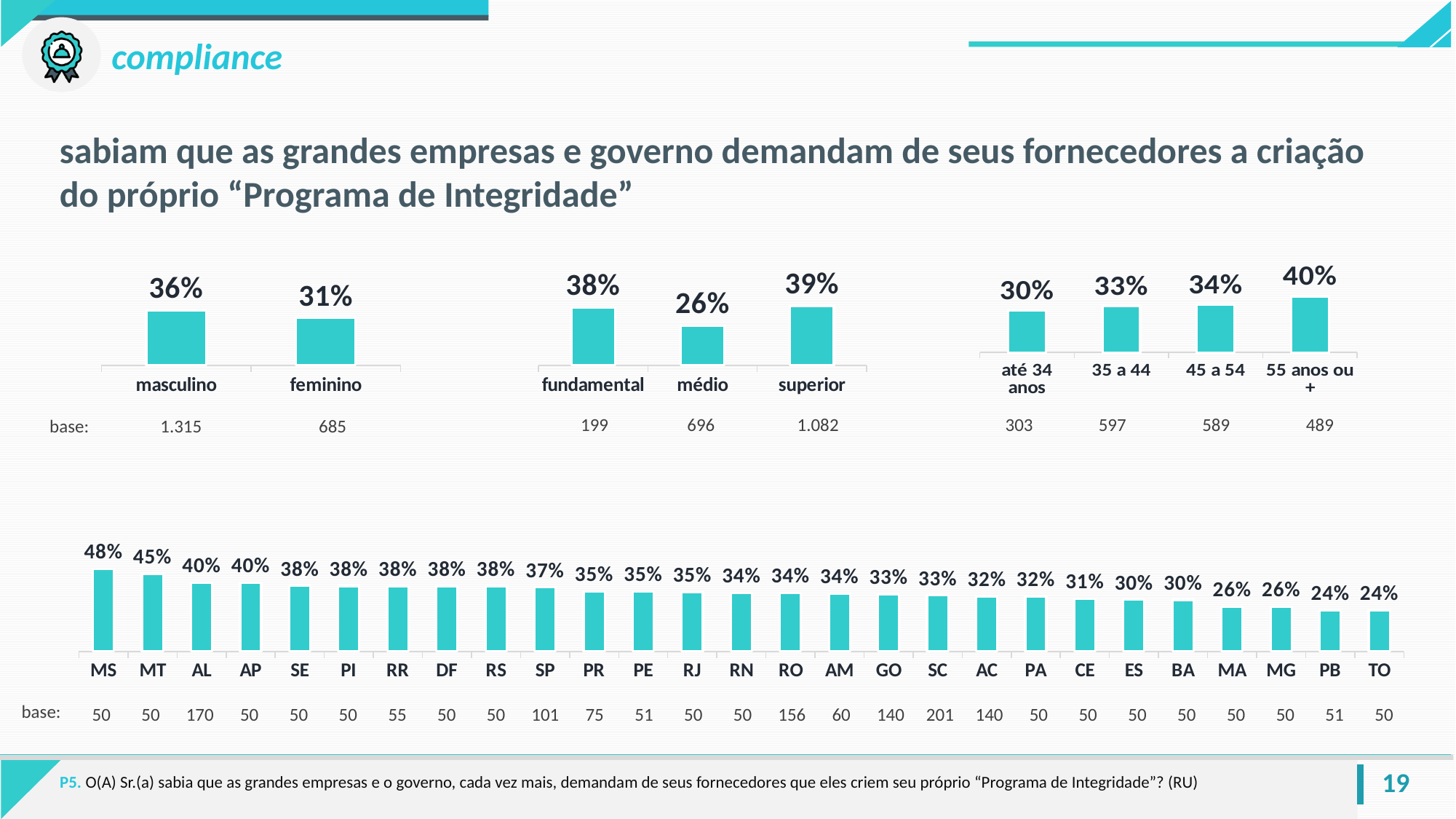
In the state chart (bottom), which state has the highest value? MS What kind of chart is the state chart at the bottom of the slide? bar chart In the age chart (top right), do the values rise or fall from the youngest to the oldest age group? rise In the age chart (top right), what is the value for 35 a 44? 33% In the state chart (bottom), how many states are shown? 27 In the gender chart (top left), what is the value for masculino? 36% In the state chart (bottom), what is the value for SP? 37% In the age chart (top right), which age group has the highest value? 55 anos ou + In the gender chart (top left), what is the difference between masculino and feminino? 5% In the education chart (top middle), which category has the lowest value? médio In the education chart (top middle), what is the value for superior? 39% In the state chart (bottom), which is larger, the value for MT or the value for AL? MT